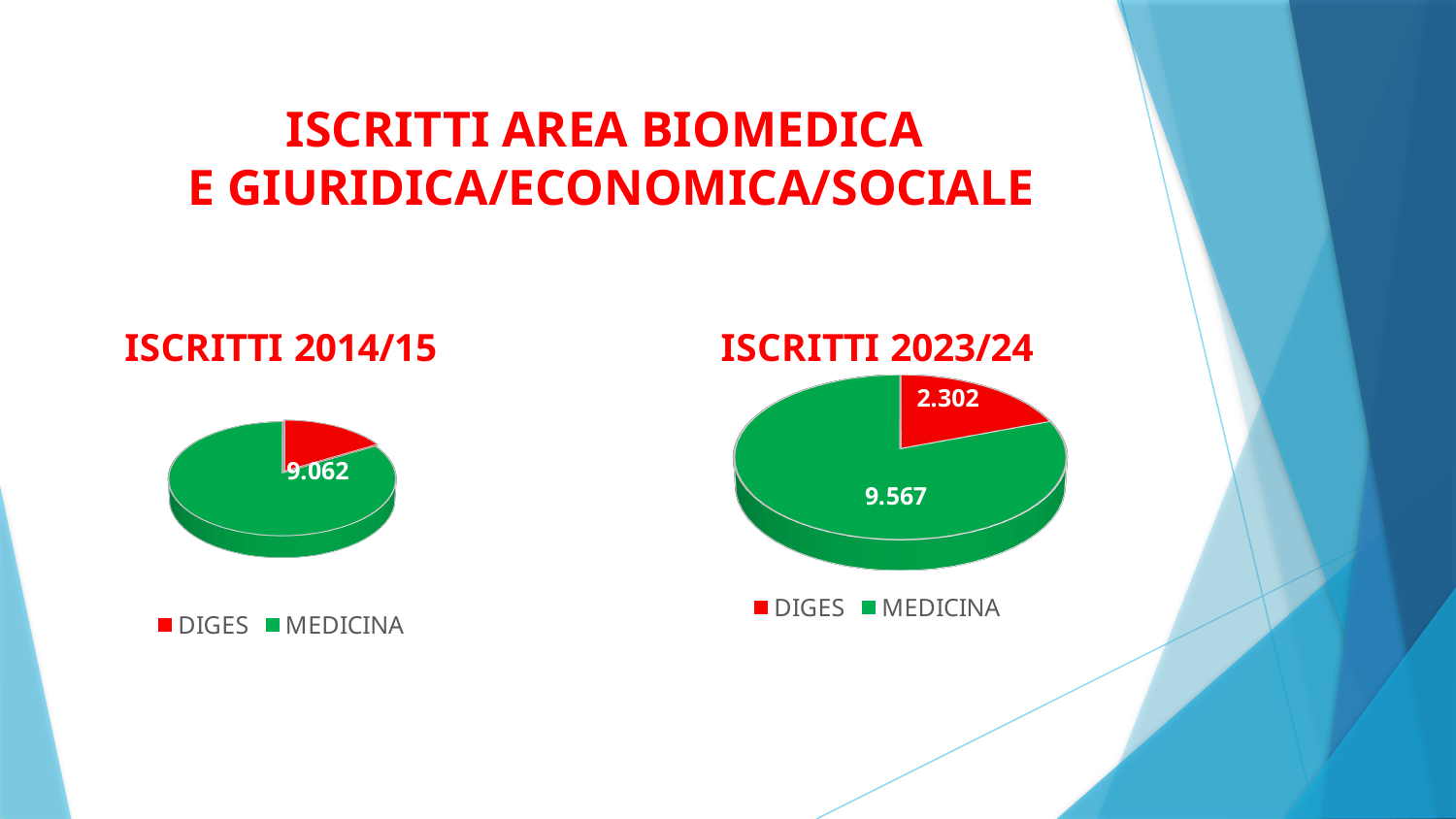
In the ISCRITTI 2023/24 chart, which is larger, DIGES or MEDICINA? MEDICINA How many categories does the ISCRITTI 2023/24 chart show? 2 In the ISCRITTI 2023/24 chart, what is the difference between the MEDICINA and DIGES values? 7.265 In the ISCRITTI 2014/15 chart, what is the value for MEDICINA? 9.062 What is the difference between the MEDICINA value in the ISCRITTI 2023/24 chart and the MEDICINA value in the ISCRITTI 2014/15 chart? 505 In the ISCRITTI 2023/24 chart, what is the value for MEDICINA? 9.567 In the ISCRITTI 2023/24 chart, which category has the smallest slice? DIGES In the ISCRITTI 2023/24 chart, which colour represents DIGES? Red In the ISCRITTI 2014/15 chart, which category has the largest slice? MEDICINA In the ISCRITTI 2023/24 chart, what is the value for DIGES? 2.302 What kind of chart is the ISCRITTI 2014/15 chart? Pie chart How many entries does the legend of the ISCRITTI 2014/15 chart list? 2